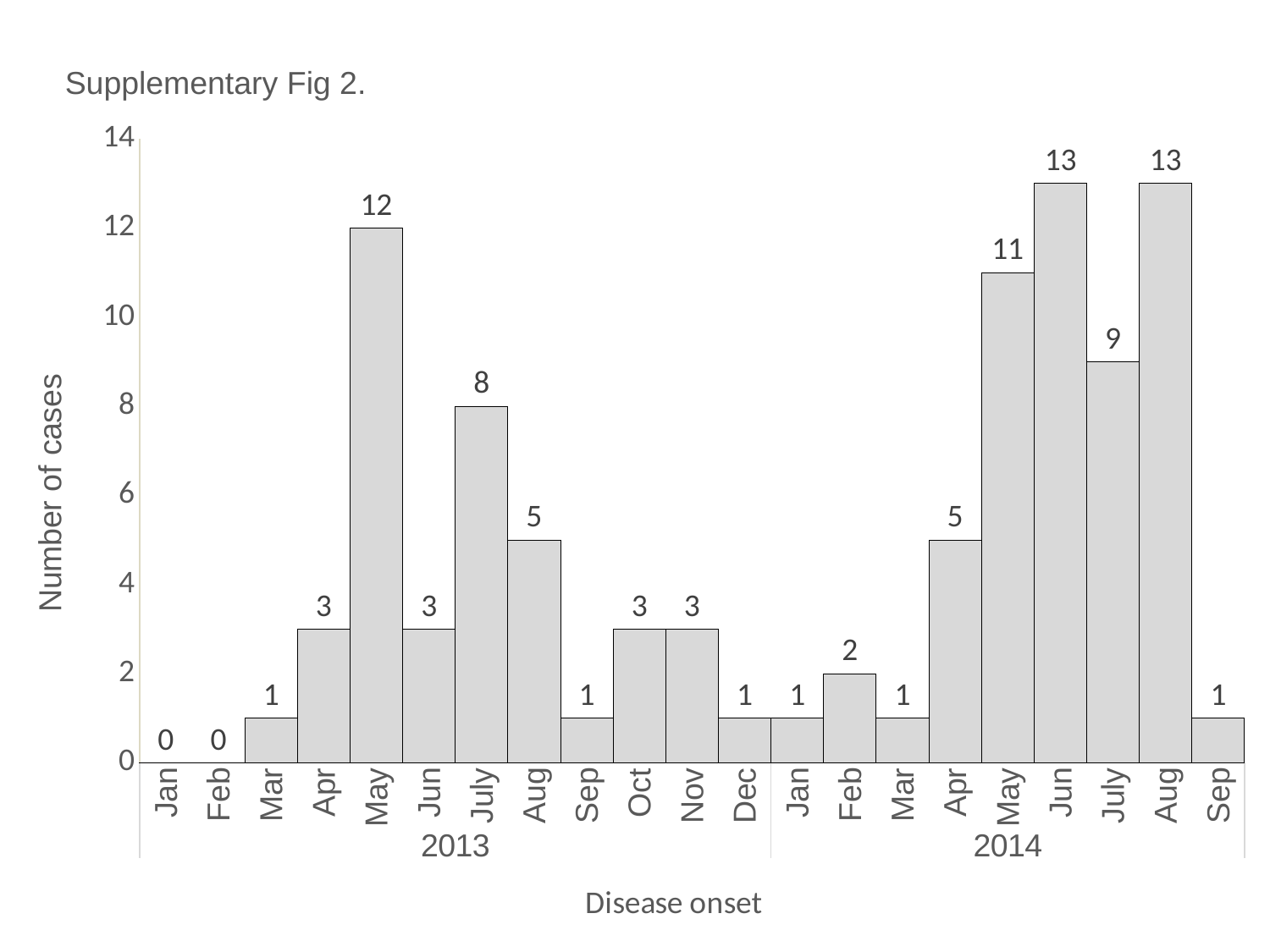
What is the label of the y axis? Number of cases How many cases were recorded in May 2013? 12 What is the difference in cases between Jun 2014 and July 2014? 4 How many cases were recorded in Feb 2014? 2 How many cases were recorded in July 2014? 9 Which has more cases, July 2013 or July 2014? July 2014 What is the difference in cases between May 2013 and May 2014? 1 How many months are shown on the x axis in total? 21 Which has more cases, Aug 2013 or Apr 2014? They are equal (5) Which month in 2013 has the highest number of cases? May What type of chart is shown? Bar chart What is the highest number of cases shown in any month? 13